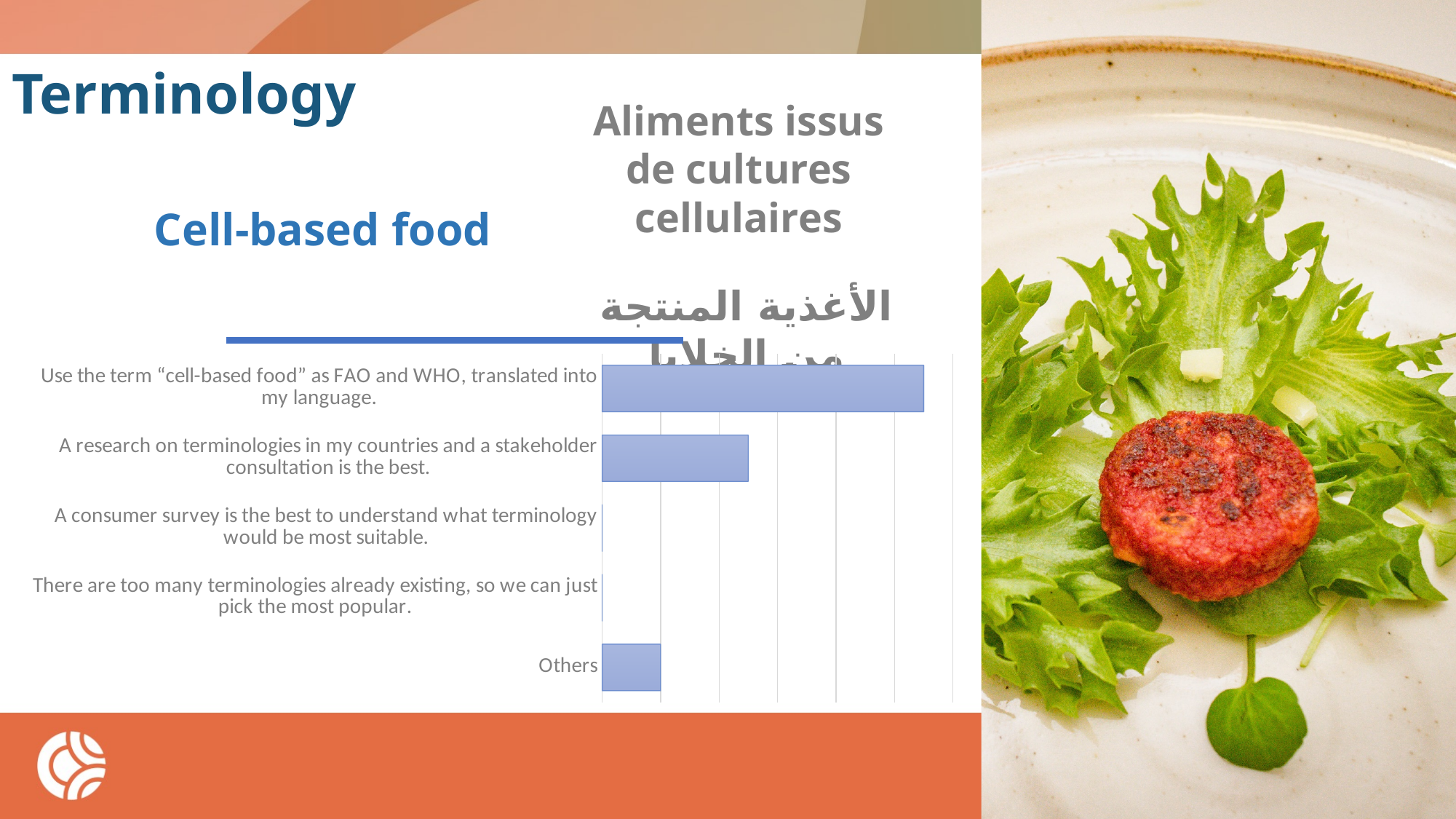
Which category has the longest bar in the chart? Use the term "cell-based food" as FAO and WHO, translated into my language. Which is larger: the bar for "A research on terminologies in my countries and a stakeholder consultation is the best." or the bar for "Others"? A research on terminologies in my countries and a stakeholder consultation is the best. Are the bars in the chart drawn horizontally or vertically? Horizontally How many categories are shown in the bar chart? 5 Which category has the second-longest bar in the chart? A research on terminologies in my countries and a stakeholder consultation is the best. Which is larger: the bar for "Others" or the bar for "A consumer survey is the best to understand what terminology would be most suitable."? Others What kind of chart is shown on the slide? Bar chart Which is larger: the bar for "Use the term "cell-based food" as FAO and WHO, translated into my language." or the bar for "A research on terminologies in my countries and a stakeholder consultation is the best."? Use the term "cell-based food" as FAO and WHO, translated into my language.